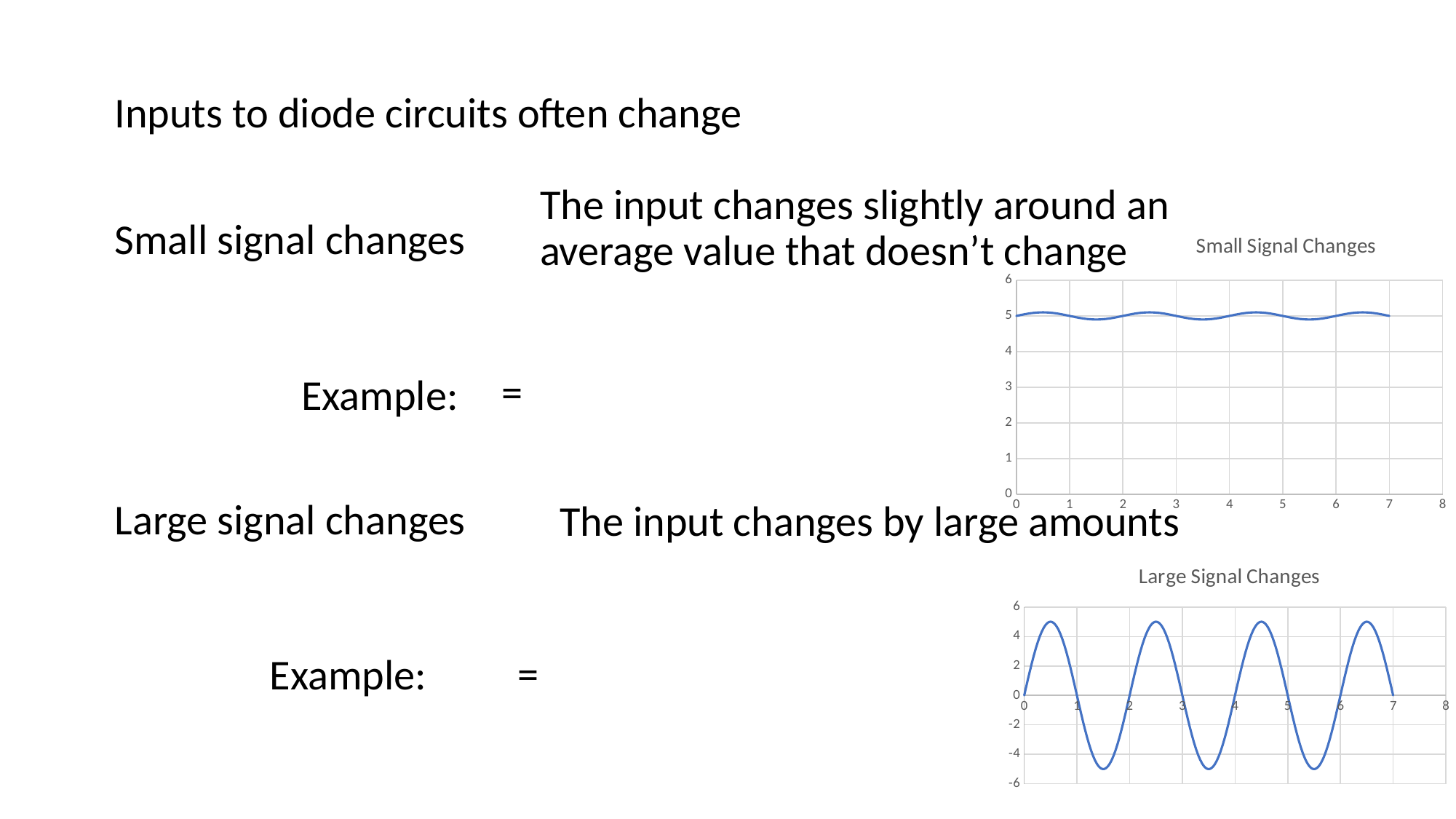
What is the title of the lower chart on the slide? Large Signal Changes In the "Large Signal Changes" chart, how many peaks does the line reach between x = 0 and x = 7? 4 What kind of chart is the "Large Signal Changes" chart? line chart What kind of chart is the "Small Signal Changes" chart? line chart What is the highest value shown on the vertical axis of the "Small Signal Changes" chart? 6 What is the title of the upper chart on the slide? Small Signal Changes In the "Large Signal Changes" chart, is the lowest value near x = 1.5 greater or less than -4? less In the "Small Signal Changes" chart, is the plotted value at x = 1 greater or less than 4? greater In the "Large Signal Changes" chart, is the peak value near x = 0.5 greater or less than 4? greater How many charts are shown on the slide? 2